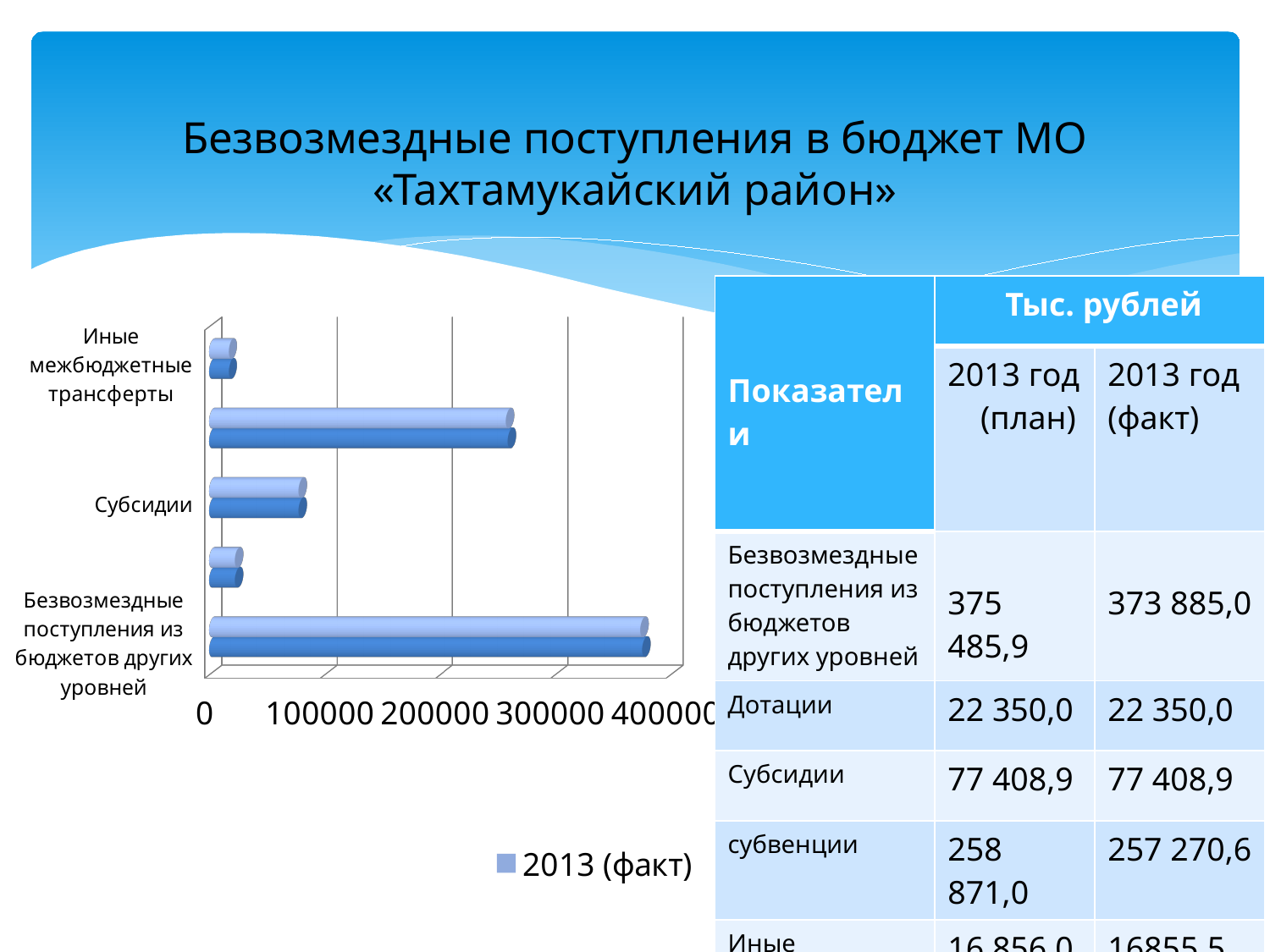
Is the value for Безвозмездные поступления из бюджетов других уровней greater or less than 300000? greater Which is larger in the chart, Субсидии or Безвозмездные поступления из бюджетов других уровней? Безвозмездные поступления из бюджетов других уровней What legend entry is shown below the chart? 2013 (факт) Is the value for Иные межбюджетные трансферты greater or less than 100000? less Which is larger in the chart, Субсидии or Иные межбюджетные трансферты? Субсидии Is the value for Субсидии greater or less than 100000? less What is the highest tick value shown on the horizontal axis of the chart? 400000 What kind of chart is shown on the slide? bar chart Which category has the longest bar in the chart? Безвозмездные поступления из бюджетов других уровней How many categories (groups of bars) are plotted in the chart? 5